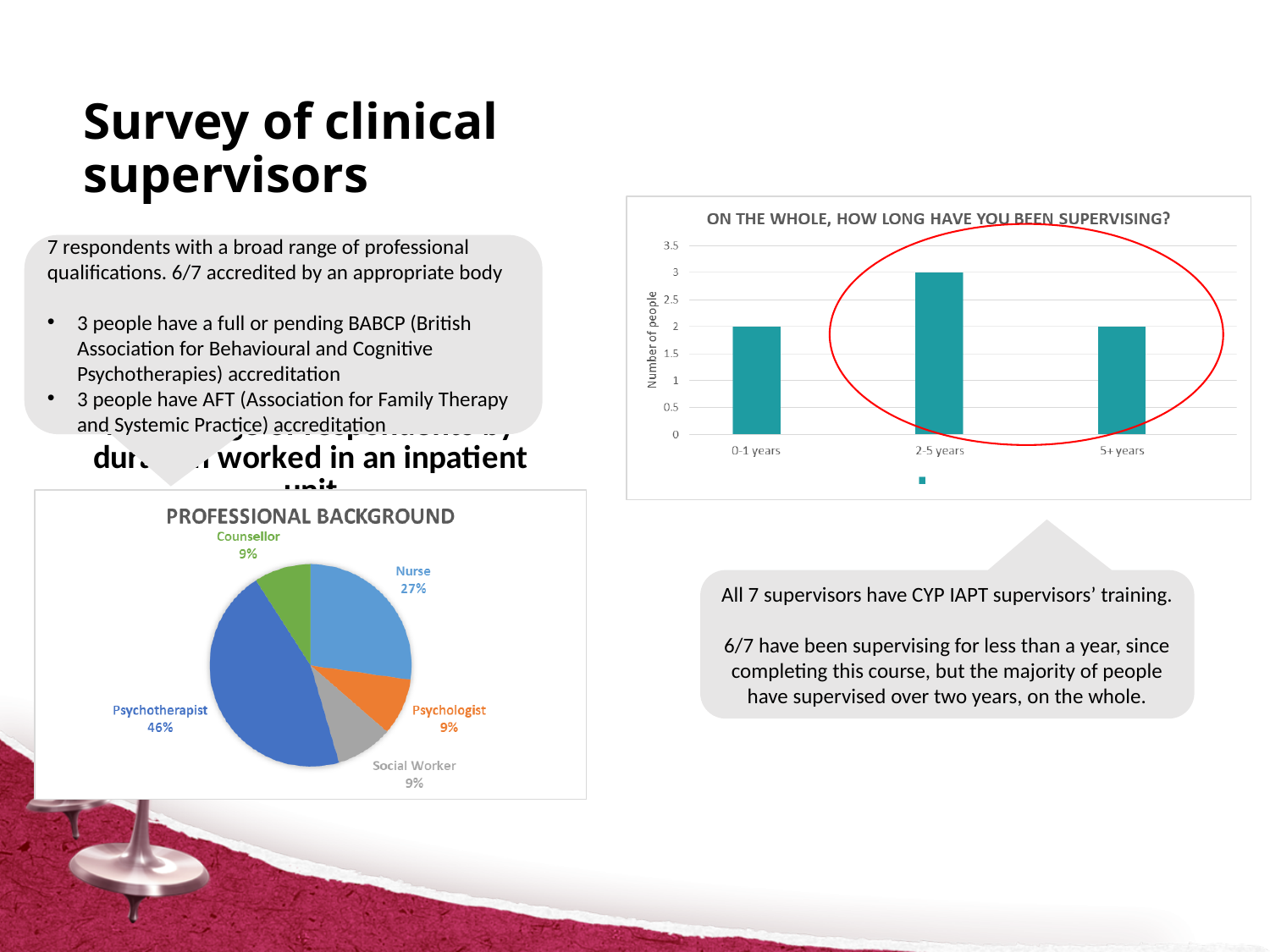
In the 'PROFESSIONAL BACKGROUND' pie chart, what share is Psychotherapist? 46% In the 'ON THE WHOLE, HOW LONG HAVE YOU BEEN SUPERVISING?' chart, what is the number of people for 2-5 years? 3 In the 'PROFESSIONAL BACKGROUND' pie chart, which profession has the largest slice? Psychotherapist In the 'ON THE WHOLE, HOW LONG HAVE YOU BEEN SUPERVISING?' chart, what is the number of people for 0-1 years? 2 In the 'PROFESSIONAL BACKGROUND' pie chart, which is larger, Nurse or Psychologist? Nurse In the 'ON THE WHOLE, HOW LONG HAVE YOU BEEN SUPERVISING?' chart, what is the difference in number of people between 2-5 years and 5+ years? 1 What kind of chart is 'ON THE WHOLE, HOW LONG HAVE YOU BEEN SUPERVISING?'? bar chart In the 'PROFESSIONAL BACKGROUND' pie chart, how many slices are there? 5 In the 'ON THE WHOLE, HOW LONG HAVE YOU BEEN SUPERVISING?' chart, what is the label of the y axis? Number of people In the 'ON THE WHOLE, HOW LONG HAVE YOU BEEN SUPERVISING?' chart, how many categories are shown on the x axis? 3 In the 'PROFESSIONAL BACKGROUND' pie chart, what share is Nurse? 27% In the 'ON THE WHOLE, HOW LONG HAVE YOU BEEN SUPERVISING?' chart, which category has the highest number of people? 2-5 years